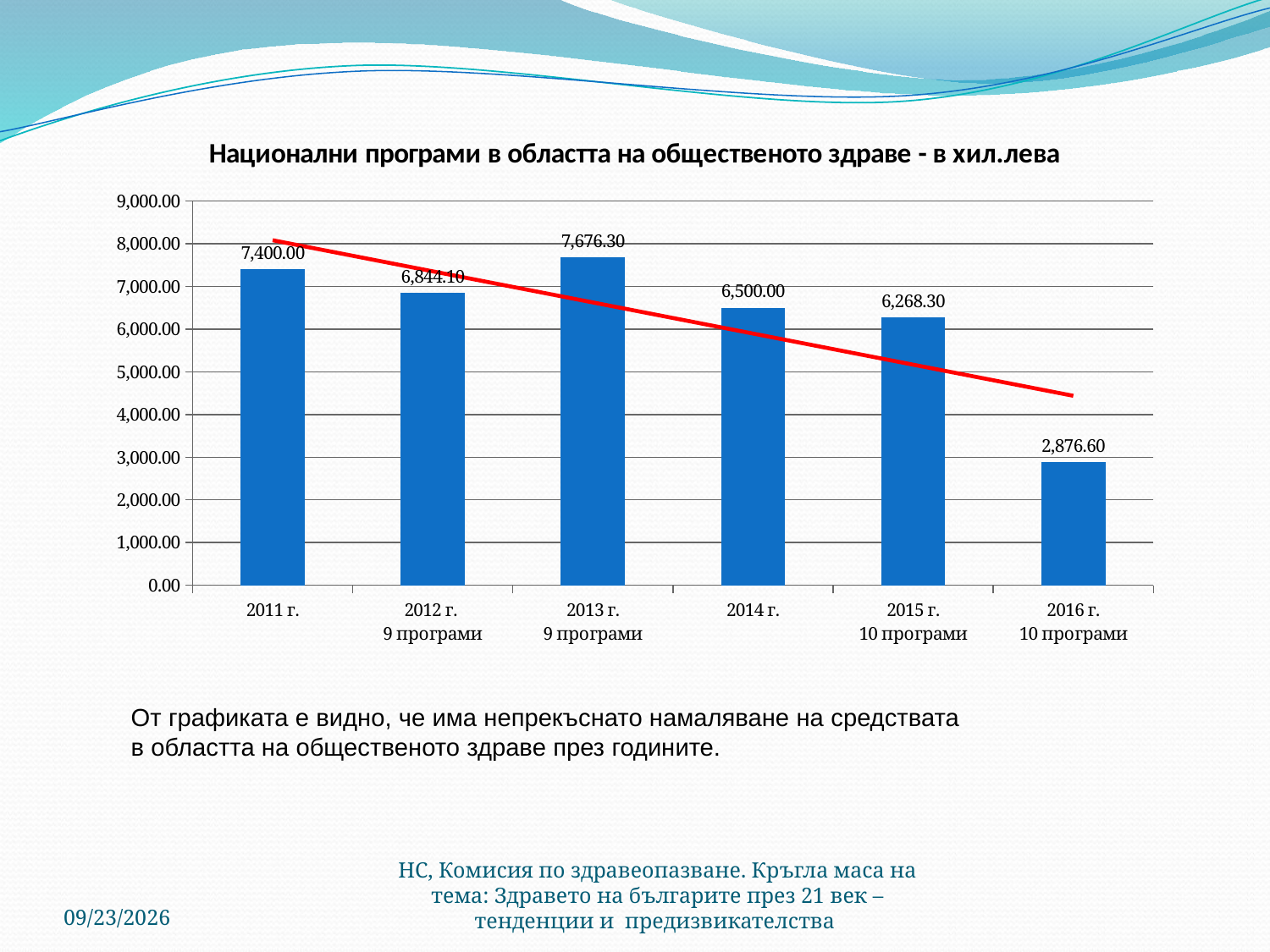
How many years are shown on the x axis? 6 What is the difference between the values for 2013 г. and 2016 г.? 4,799.70 Which year has the lowest value? 2016 г. Do the values generally rise or fall from 2011 г. to 2016 г.? fall Which year has the highest value? 2013 г. What is the value for 2014 г.? 6,500.00 What is the value for 2011 г.? 7,400.00 What is the difference between the values for 2011 г. and 2012 г.? 555.90 Is the value for 2015 г. greater or less than 6,000.00? greater What kind of chart is this? bar chart What is the value for 2016 г.? 2,876.60 Which is larger, the value for 2012 г. or the value for 2015 г.? 2012 г.